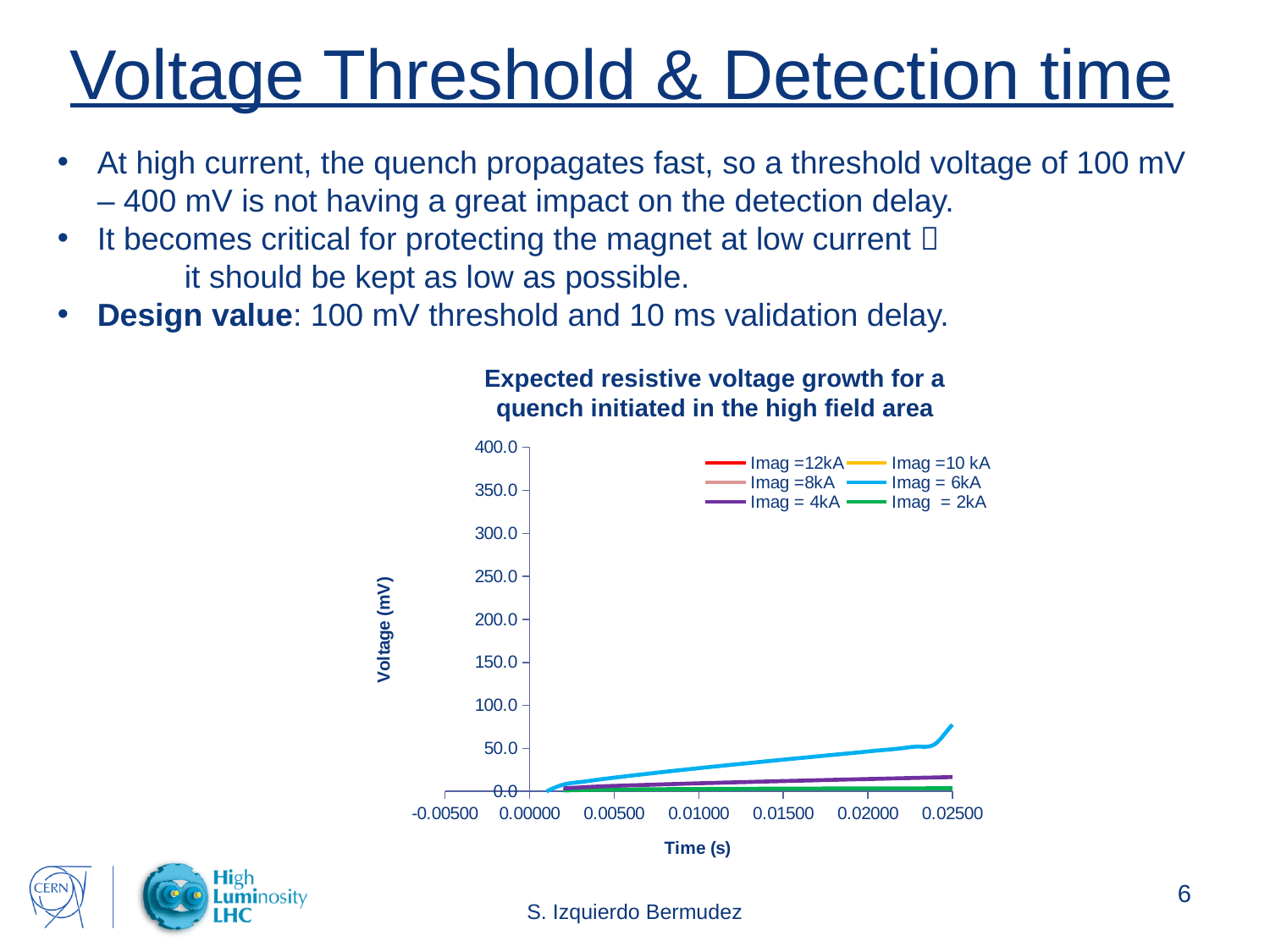
Is the value of the Imag = 6kA line at time 0.02000 greater or less than 100.0 mV? less What is the title of the chart? Expected resistive voltage growth for a quench initiated in the high field area What is the maximum value shown on the vertical axis? 400.0 What is the label of the vertical axis? Voltage (mV) At time 0.02000, which line is higher: Imag = 6kA or Imag = 4kA? Imag = 6kA What kind of chart is shown on the slide? line chart Is the value of the Imag = 4kA line at time 0.02500 greater or less than 50.0 mV? less At time 0.02000, which line is higher: Imag = 4kA or Imag = 2kA? Imag = 4kA Does the Imag = 6kA line rise or fall as time increases? rise Is the value of the Imag = 6kA line at time 0.02500 greater or less than 100.0 mV? less How many series does the legend list? 6